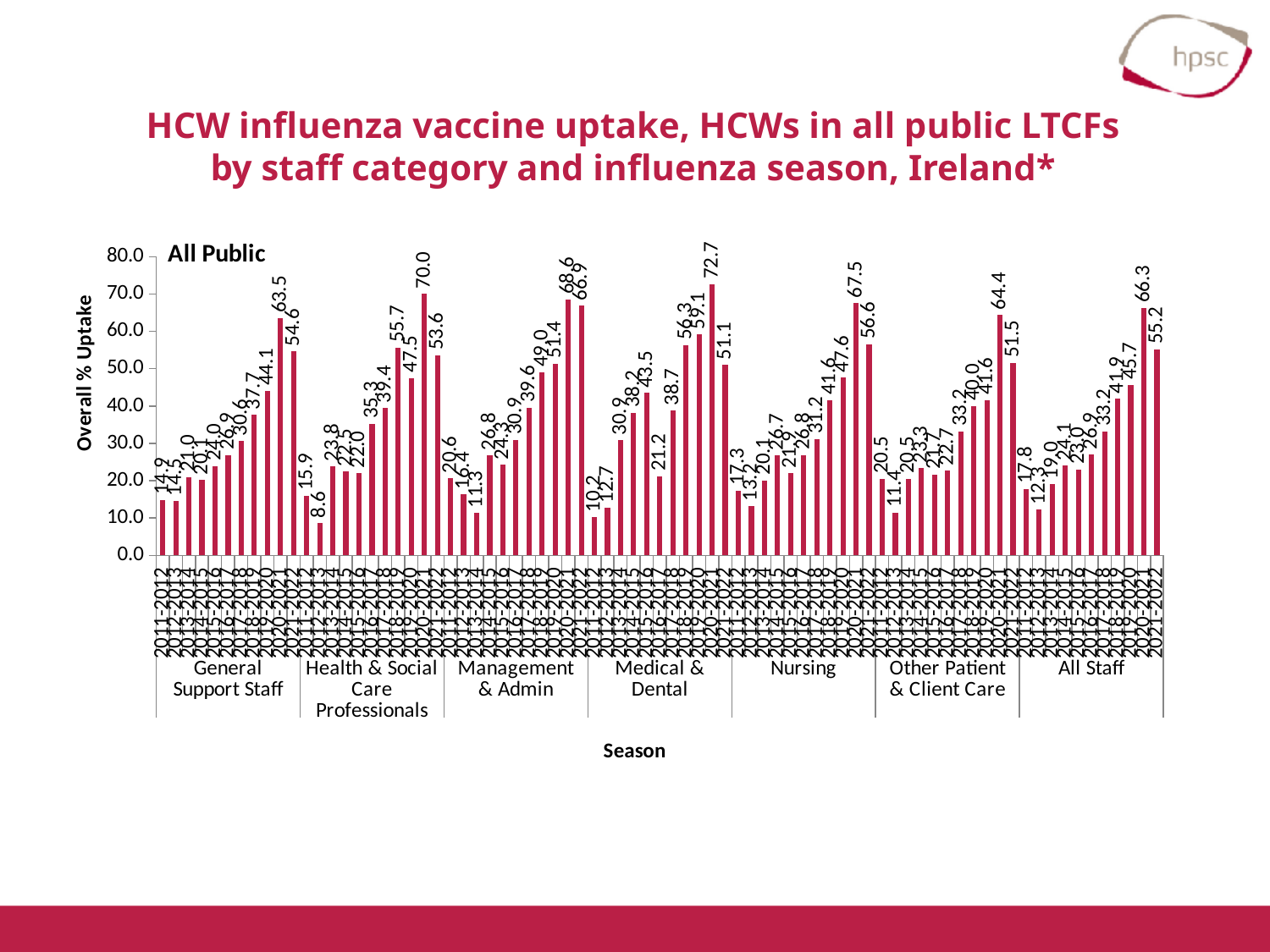
What is the value of the tallest bar in the All Staff group? 66.3 Is the value of the last bar in the All Staff group greater or less than 50.0? greater What is the difference between the tallest bar in the Medical & Dental group (72.7) and the tallest bar in the Health & Social Care Professionals group (70.0)? 2.7 What is the value of the tallest bar in the Health & Social Care Professionals group? 70.0 What is the value of the tallest bar in the Other Patient & Client Care group? 64.4 What is the label on the vertical axis of the chart? Overall % Uptake What is the lowest value shown anywhere on the chart, and in which staff category does it occur? 8.6, Health & Social Care Professionals Which is larger: the tallest bar in the General Support Staff group or the tallest bar in the Management & Admin group? Management & Admin What is the value of the tallest bar in the Nursing group? 67.5 How many staff categories are shown along the x axis of the chart? 7 What kind of chart is shown on the slide? bar chart What is the highest value shown anywhere on the chart, and in which staff category does it occur? 72.7, Medical & Dental